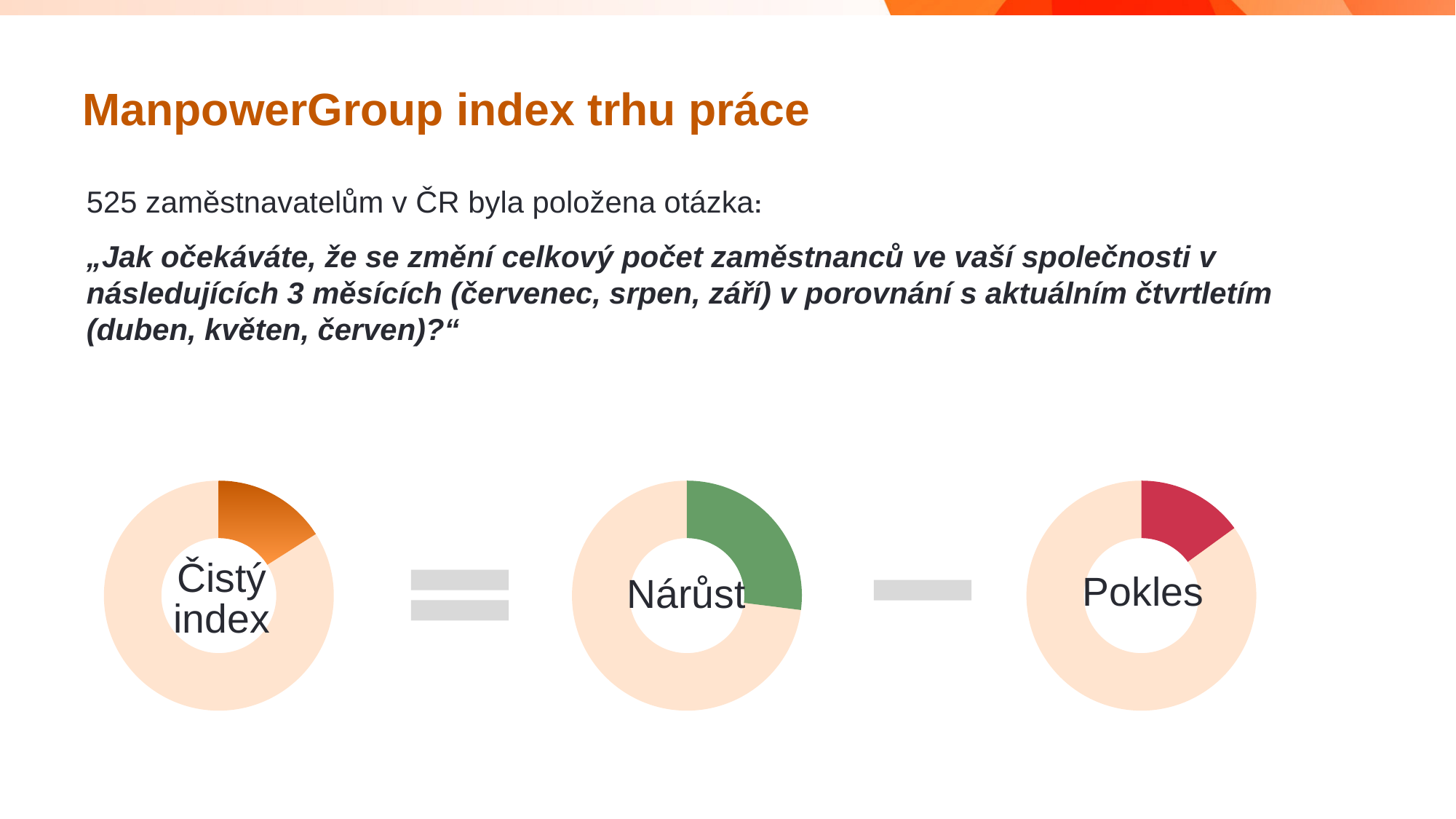
How many donut charts are shown on the slide? 3 What colour is the highlighted slice in the "Pokles" donut chart? red What kind of chart is the left chart labelled "Čistý index"? donut chart Which highlighted slice is larger, the green slice in the "Nárůst" chart or the red slice in the "Pokles" chart? Nárůst What label appears in the centre of the middle donut chart? Nárůst Which of the three donut charts has the largest highlighted slice? Nárůst In the "Nárůst" donut chart, is the green slice greater or less than half of the ring? less Is the orange slice in the "Čistý index" chart larger or smaller than the green slice in the "Nárůst" chart? smaller